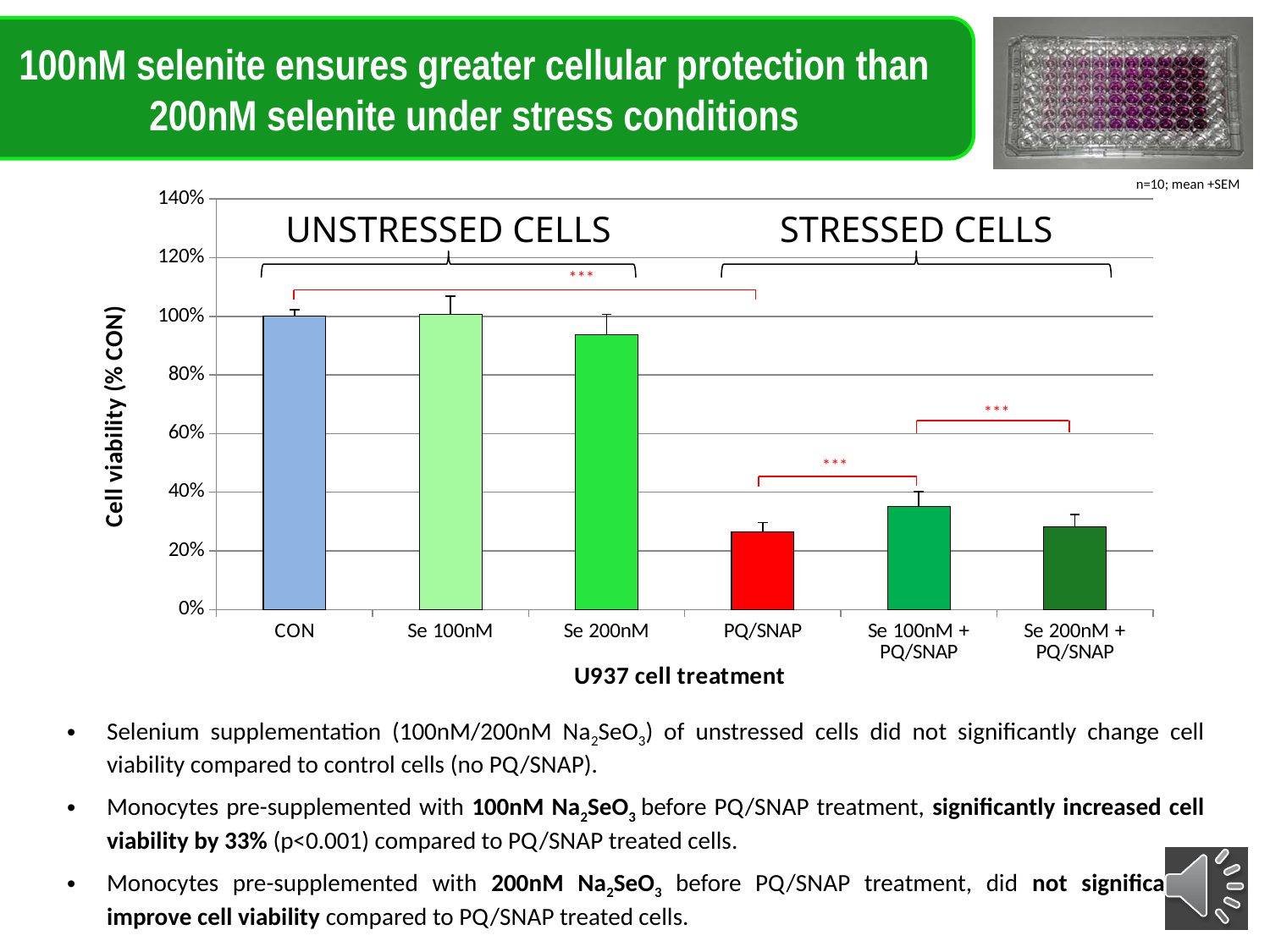
What is the title of the y axis? Cell viability (% CON) Is the value for Se 200nM + PQ/SNAP greater or less than 20%? greater How many treatment categories are plotted on the x axis? 6 What is the cell viability value for CON? 100% Is the value for Se 100nM greater or less than 80%? greater Is the value for PQ/SNAP greater or less than 40%? less What is the title of the x axis? U937 cell treatment Which has the larger cell viability, PQ/SNAP or Se 100nM + PQ/SNAP? Se 100nM + PQ/SNAP Which has the larger cell viability, Se 200nM or PQ/SNAP? Se 200nM What kind of chart is shown on the slide? bar chart